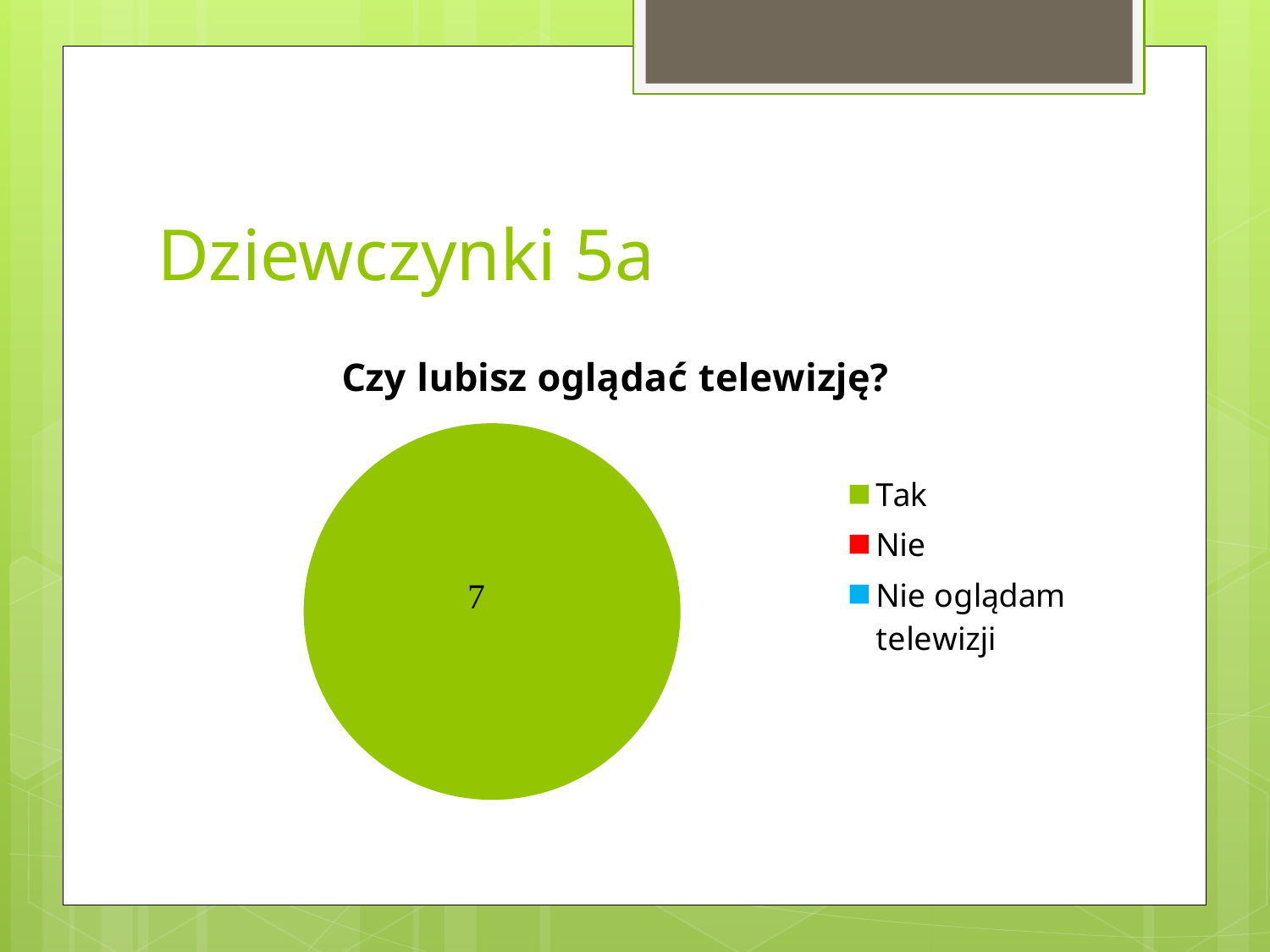
What value is shown for the "Tak" slice of the pie chart? 7 Is the value for "Tak" greater or less than 5? greater Which category is larger in the pie chart, "Tak" or "Nie"? Tak Which category makes up the largest part of the pie chart? Tak How many entries does the chart legend list? 3 What share of the pie does the "Tak" slice take up? 100% What is the title of the chart? Czy lubisz oglądać telewizję? What colour represents "Tak" in the chart legend? green What kind of chart is shown on the slide? pie chart